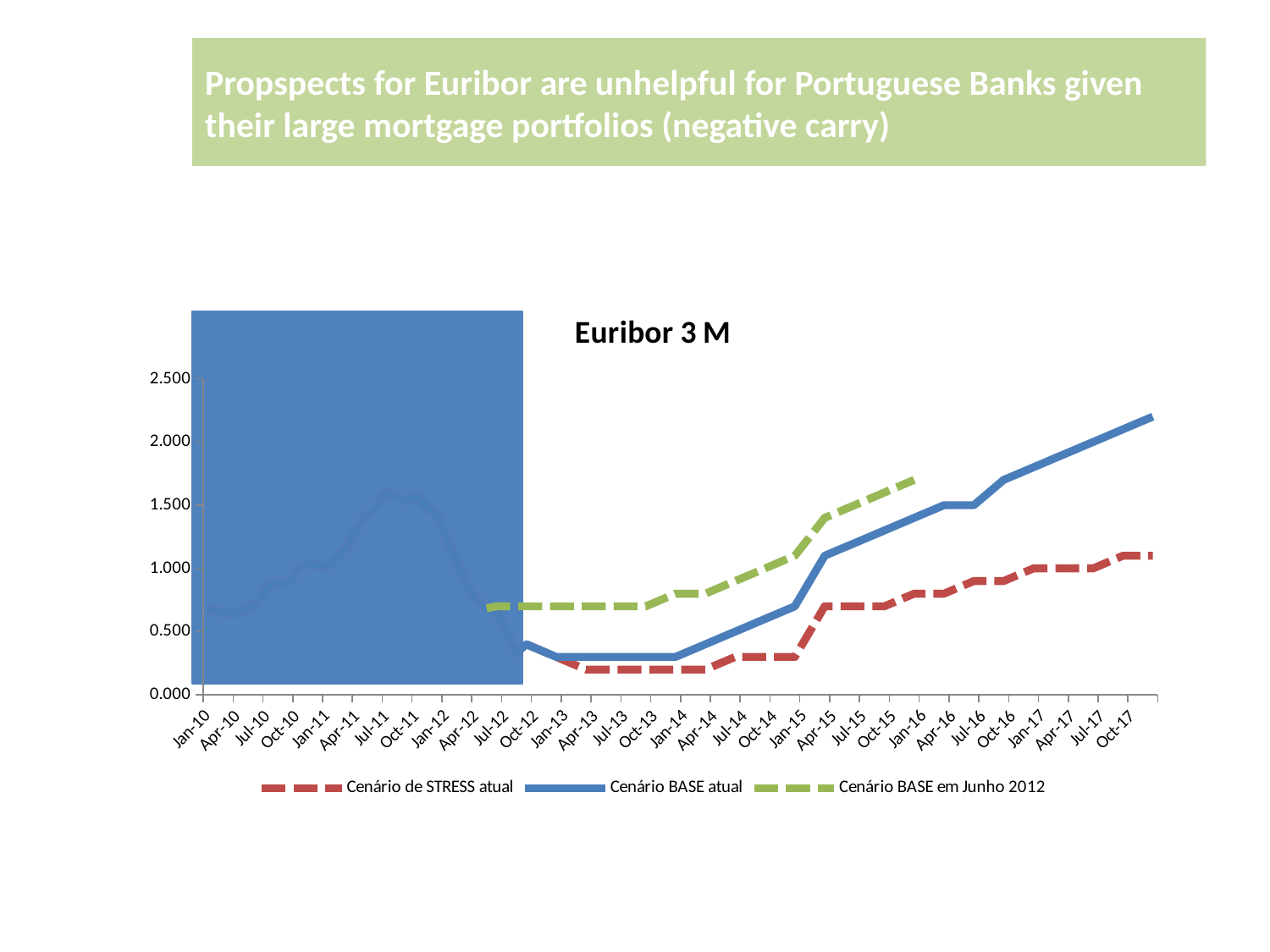
Is the value of Cenário BASE atual at Oct-17 greater or less than 2.000? greater Is the value of Cenário BASE atual at Jan-13 greater or less than 0.500? less Does Cenário BASE atual rise or fall between Jan-14 and Oct-17? rise Which series is drawn as a solid blue line? Cenário BASE atual How many series does the legend of the Euribor 3 M chart list? 3 At Oct-17, which is larger: Cenário BASE atual or Cenário de STRESS atual? Cenário BASE atual At Jan-15, which is larger: Cenário BASE em Junho 2012 or Cenário BASE atual? Cenário BASE em Junho 2012 What kind of chart is shown on the slide? line chart What is the title of the chart? Euribor 3 M Is the value of Cenário de STRESS atual at Oct-17 greater or less than 1.500? less Which series has the lowest value at Jan-15? Cenário de STRESS atual